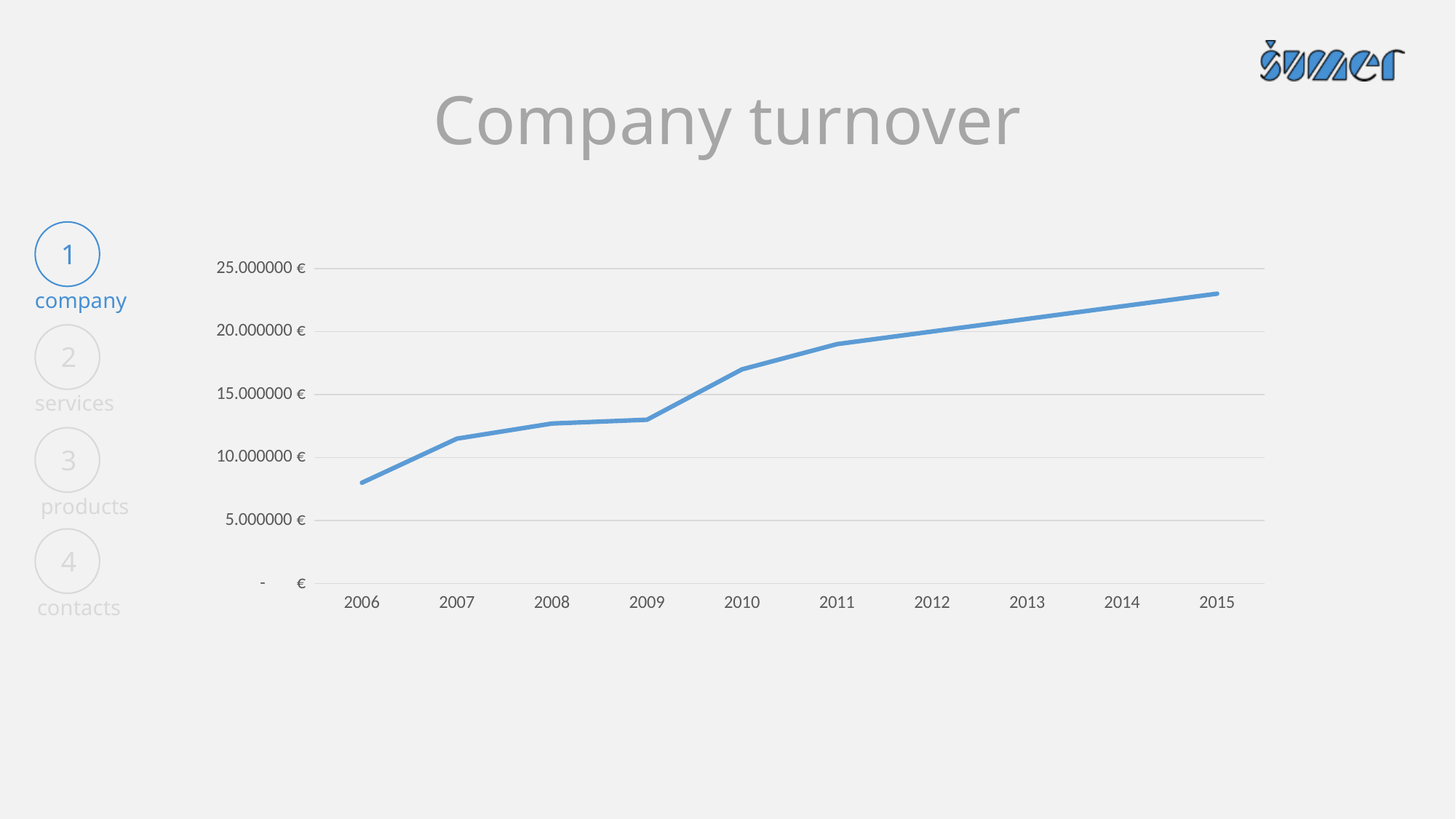
Is the value for 2010 greater or less than 15.000000 €? greater Which year has the larger turnover, 2008 or 2010? 2010 What is the title of the chart? Company turnover What currency symbol is shown on the y axis? € Does the turnover rise or fall from 2006 to 2015? rise How many years are plotted on the x axis? 10 What kind of chart is shown on the slide? line chart Is the value for 2015 greater or less than 20.000000 €? greater Is the value for 2006 greater or less than 10.000000 €? less Which year has the lowest turnover? 2006 Which year has the highest turnover? 2015